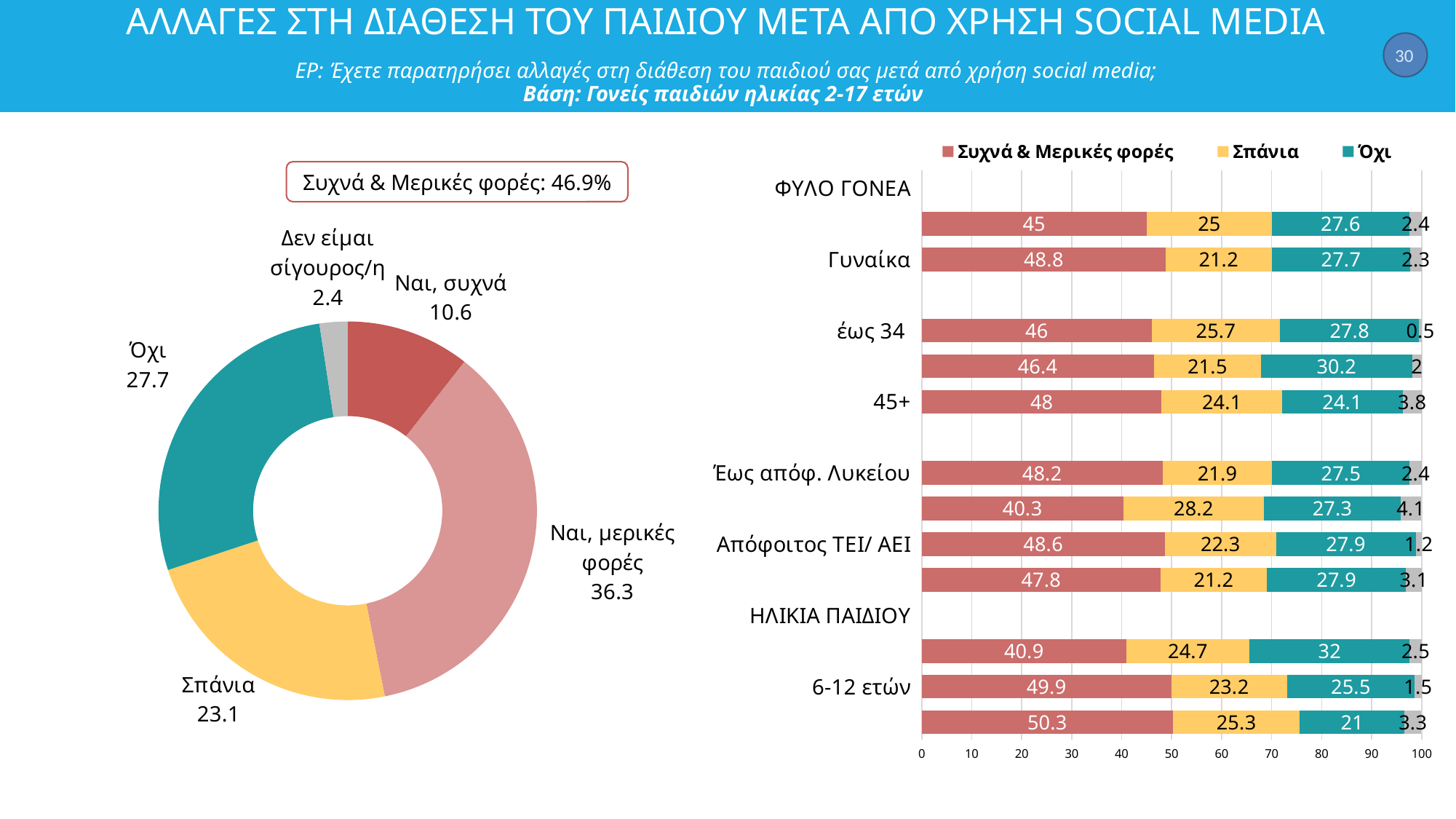
In the bar chart on the right, which is larger: the "Συχνά & Μερικές φορές" value for "45+" or for "Απόφοιτος ΤΕΙ/ ΑΕΙ"? Απόφοιτος ΤΕΙ/ ΑΕΙ In the donut chart on the left, what is the value for "Ναι, μερικές φορές"? 36.3 In the donut chart on the left, which category has the smallest value? Δεν είμαι σίγουρος/η What type of chart is shown on the right side of the slide? Stacked bar chart In the donut chart on the left, what is the value for "Όχι"? 27.7 In the donut chart on the left, how many categories are shown? 5 In the bar chart on the right, what is the "Σπάνια" value for "έως 34"? 25.7 In the donut chart on the left, what is the difference between "Όχι" and "Σπάνια"? 4.6 In the bar chart on the right, what is the "Όχι" value for "6-12 ετών"? 25.5 In the bar chart on the right, what is the "Συχνά & Μερικές φορές" value for "Γυναίκα"? 48.8 In the donut chart on the left, which category has the largest value? Ναι, μερικές φορές In the bar chart on the right, how many series does the legend list? 3